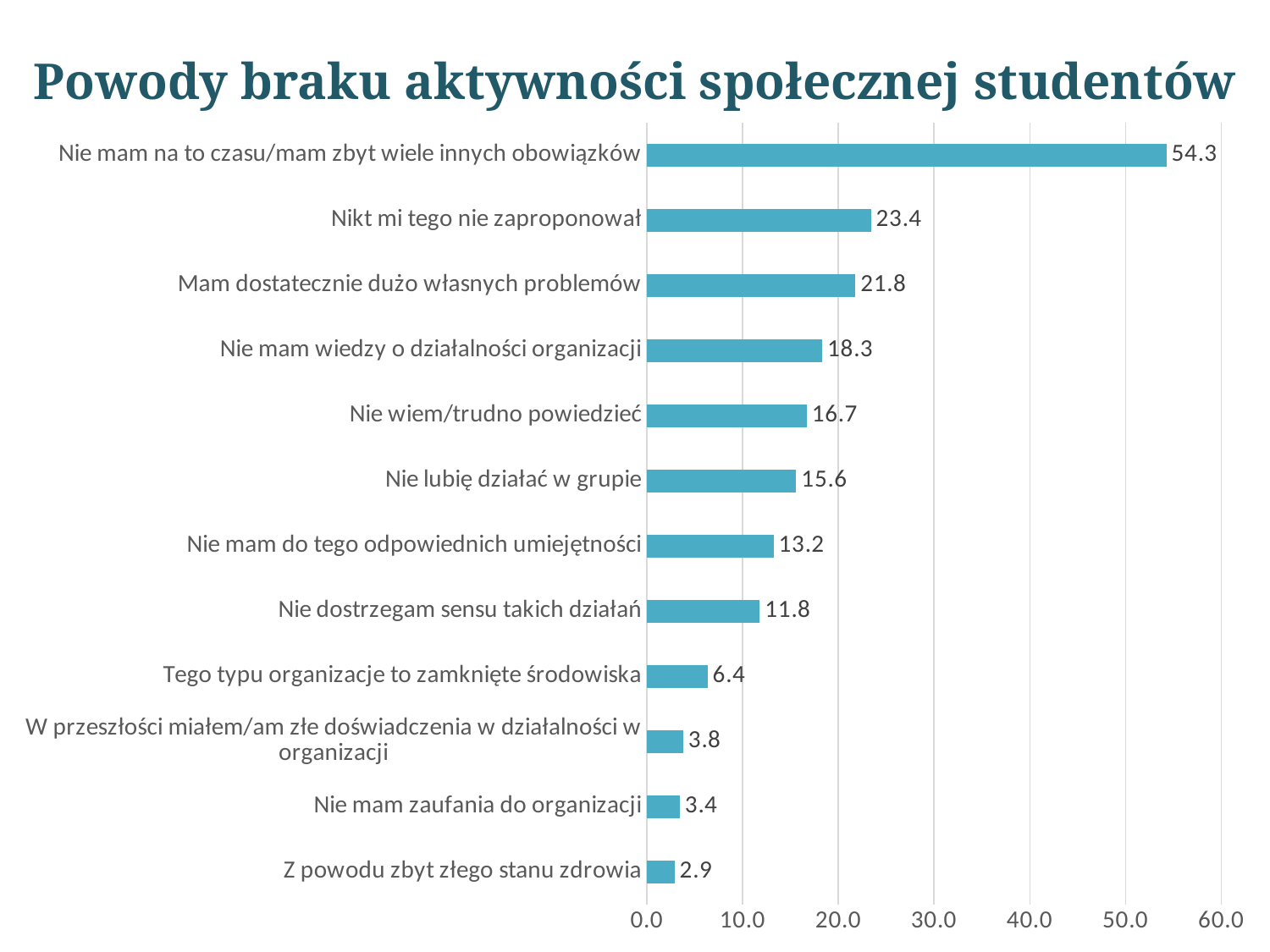
What kind of chart is shown on the slide? bar chart How many categories are shown in the chart? 12 What is the value for "Nie mam zaufania do organizacji"? 3.4 What is the value for "Nie lubię działać w grupie"? 15.6 What is the difference between the values for "Nie mam na to czasu/mam zbyt wiele innych obowiązków" and "Nikt mi tego nie zaproponował"? 30.9 Which is larger: the value for "Mam dostatecznie dużo własnych problemów" or for "Nie mam do tego odpowiednich umiejętności"? Mam dostatecznie dużo własnych problemów What is the value for "Nikt mi tego nie zaproponował"? 23.4 Which category has the highest value? Nie mam na to czasu/mam zbyt wiele innych obowiązków What is the difference between the values for "Nie mam wiedzy o działalności organizacji" and "Nie wiem/trudno powiedzieć"? 1.6 Which category has the lowest value? Z powodu zbyt złego stanu zdrowia What is the title of the chart? Powody braku aktywności społecznej studentów Is the value for "Nie dostrzegam sensu takich działań" greater or less than 10.0? greater